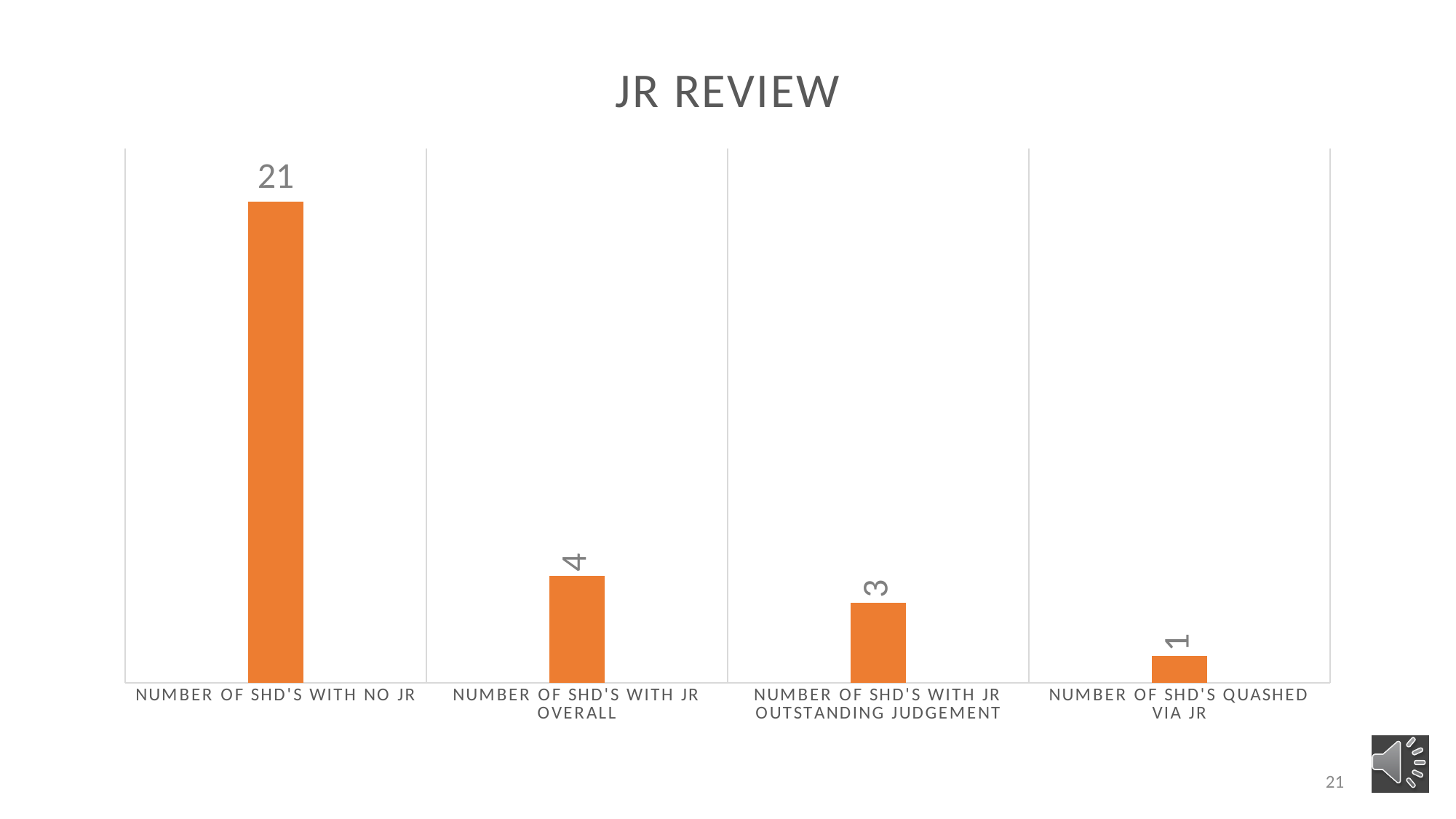
Which is larger: Number of SHD's with JR overall or Number of SHD's with JR outstanding judgement? Number of SHD's with JR overall What is the value for Number of SHD's with no JR? 21 How many categories are shown in the chart? 4 What is the title of the chart? JR REVIEW What is the value for Number of SHD's with JR overall? 4 What is the value for Number of SHD's with JR outstanding judgement? 3 What kind of chart is shown on the slide? Bar chart What is the difference between Number of SHD's with JR overall and Number of SHD's quashed via JR? 3 Which category has the highest value? Number of SHD's with no JR What is the value for Number of SHD's quashed via JR? 1 What is the difference between Number of SHD's with no JR and Number of SHD's with JR overall? 17 Which category has the lowest value? Number of SHD's quashed via JR